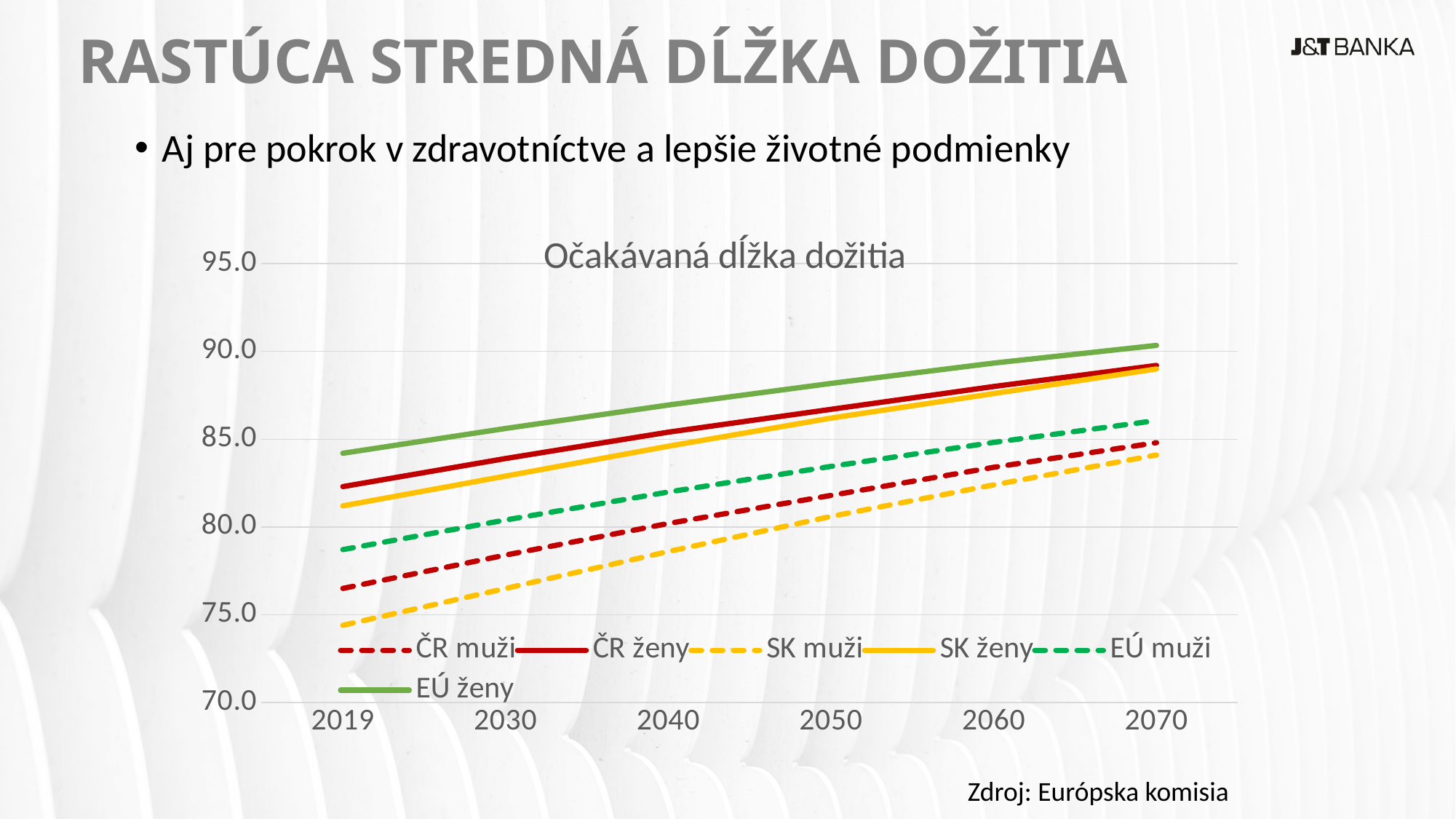
Which series has the lowest value in 2019? SK muži Is the value for ČR ženy in 2019 greater or less than 80.0? greater What kind of chart is shown on the slide? line chart Is the value for EÚ muži in 2019 greater or less than 80.0? less How many years are marked on the x axis of the chart? 6 How many series does the legend of the chart list? 6 In 2070, which is larger: the value for EÚ ženy or the value for SK muži? EÚ ženy Which series has the highest value in 2070? EÚ ženy Do the values for ČR muži rise or fall from 2019 to 2070? rise Which series has the highest value in 2019? EÚ ženy Is the value for SK muži in 2019 greater or less than 75.0? less What is the title of the chart? Očakávaná dĺžka dožitia